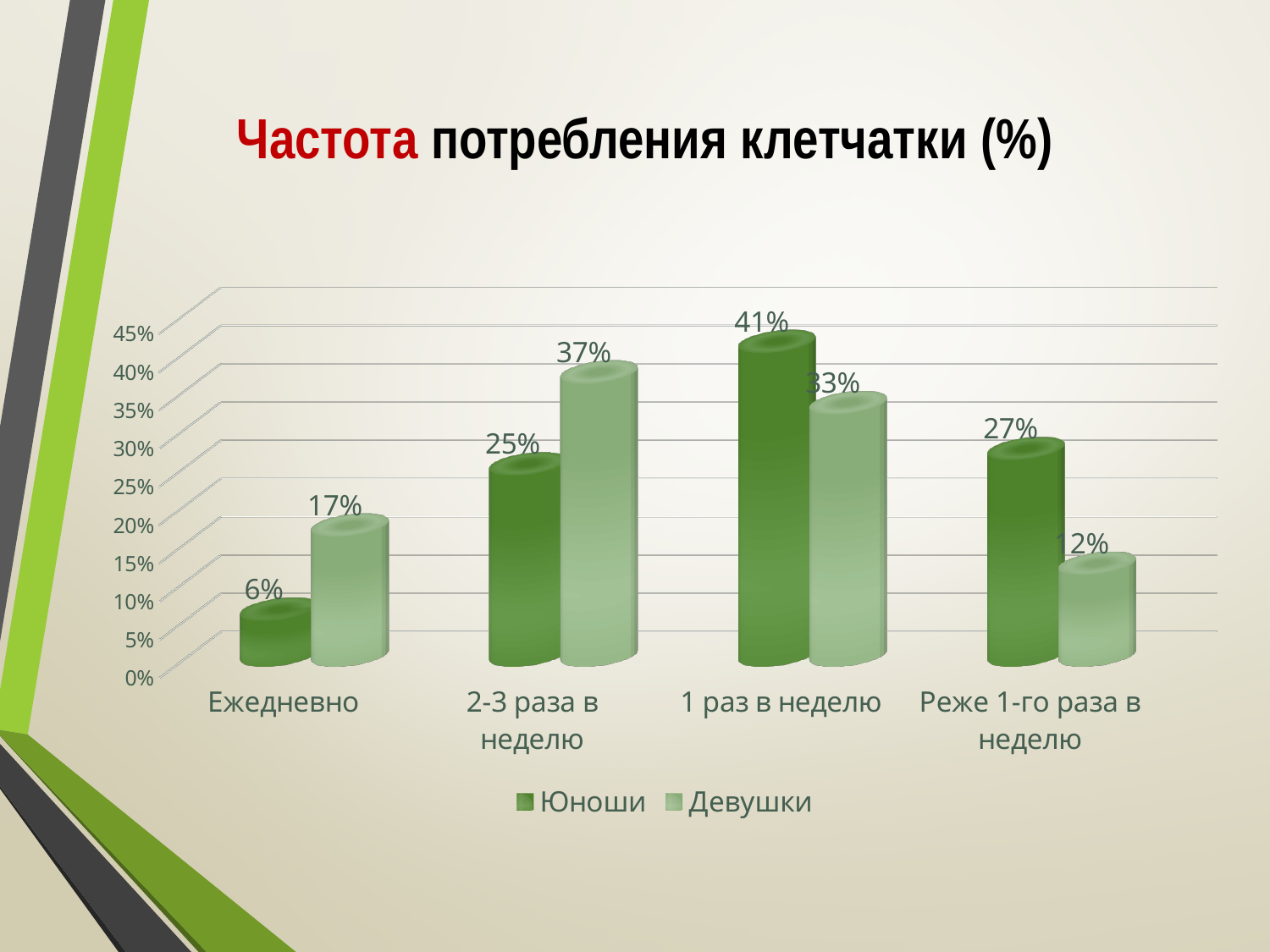
Which category has the lowest value for Девушки? Реже 1-го раза в неделю Which category has the highest value for Юноши? 1 раз в неделю What is the title of the chart? Частота потребления клетчатки (%) How many categories are shown on the x axis? 4 What kind of chart is shown on the slide? bar chart What is the value for Девушки in the Реже 1-го раза в неделю category? 12% What is the difference between Юноши and Девушки in the 1 раз в неделю category? 8% What is the value for Девушки in the 2-3 раза в неделю category? 37% Which is larger in the Ежедневно category, Юноши or Девушки? Девушки How many series does the legend list? 2 What is the value for Юноши in the Ежедневно category? 6% Is the value for Юноши in the 2-3 раза в неделю category greater or less than 30%? less